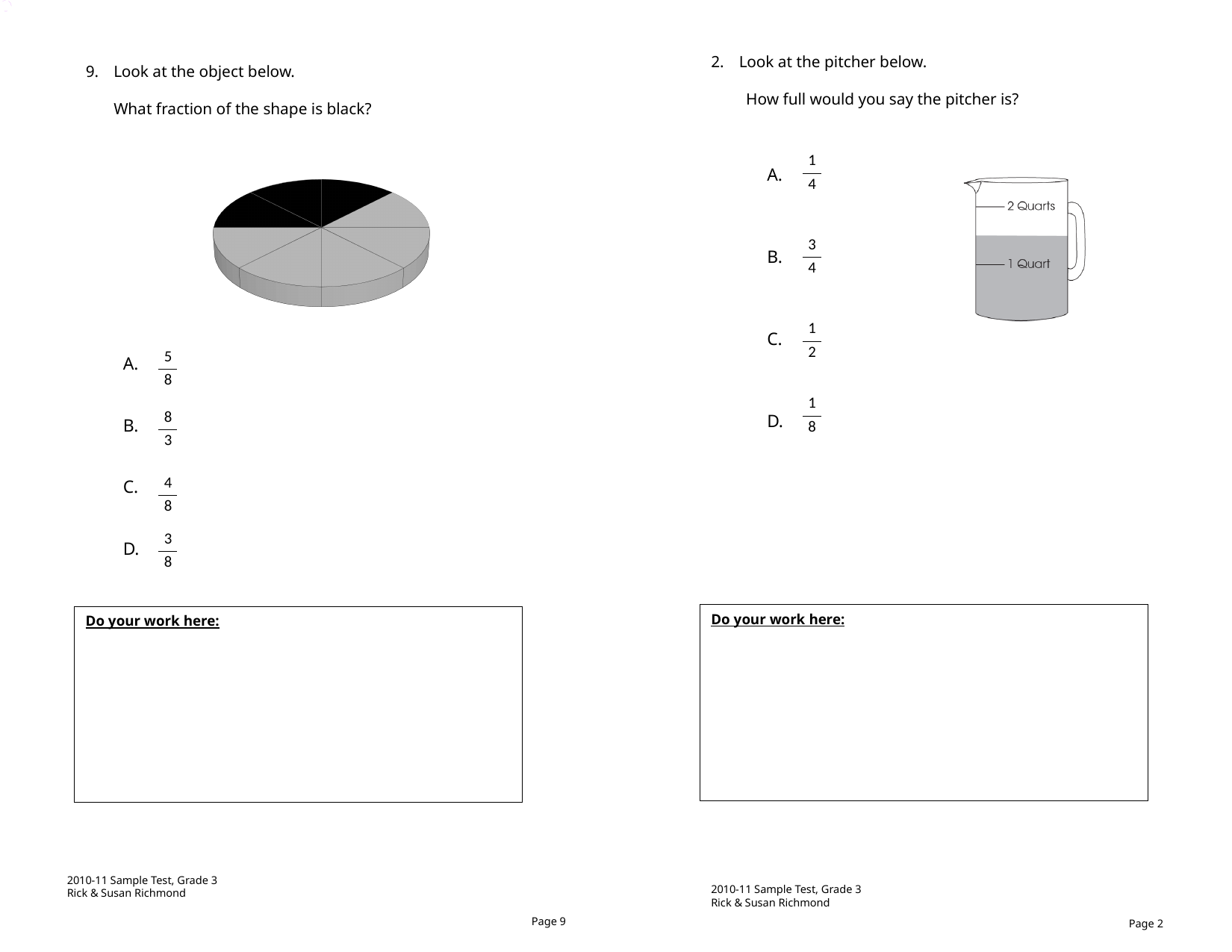
Does the pie chart under question 9 have a legend? No What kind of chart is shown on the left side of the slide, under question 9? pie chart Is the pie chart under question 9 drawn in 3D or flat 2D? 3D How many slices of the pie chart under question 9 are gray? 5 How many slices does the pie chart under question 9 have? 8 How many slices of the pie chart under question 9 are black? 3 In the pie chart under question 9, are there more black slices or more gray slices? gray